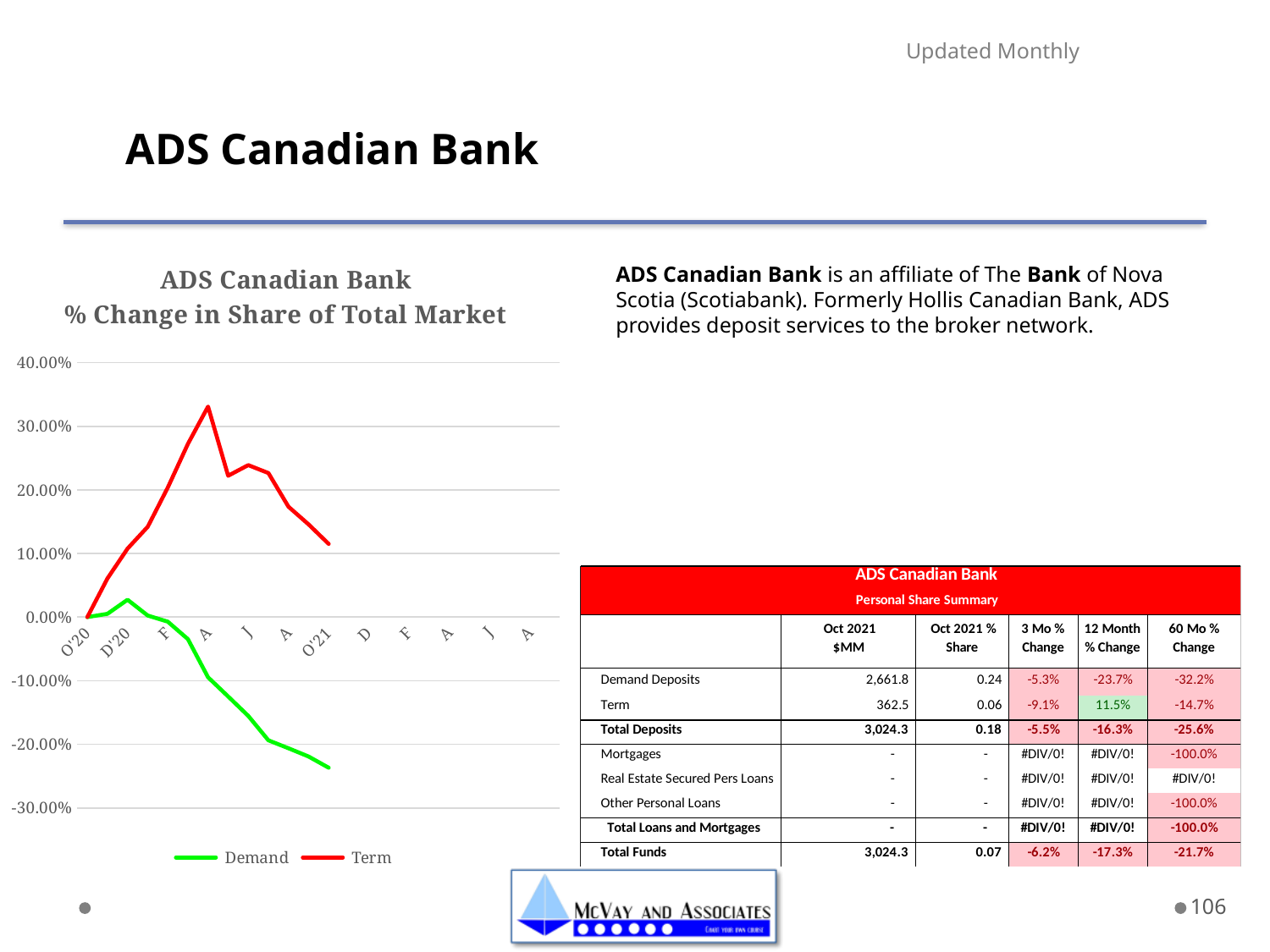
Is the value of the Term series at F (2021) greater or less than 10.00%? greater Is the value of the Demand series at O'21 greater or less than -20.00%? less How many labels are shown along the chart's x axis? 12 What kind of chart is shown on the slide? line chart Is the peak value of the Term series greater or less than 30.00%? greater What is the title of the chart? ADS Canadian Bank % Change in Share of Total Market How many series does the chart's legend list? 2 Which colour is used for the Term series in the chart? red At O'21, which series has the higher value, Demand or Term? Term What is the highest value shown on the chart's y axis? 40.00% Does the Demand series rise or fall overall from O'20 to O'21? fall